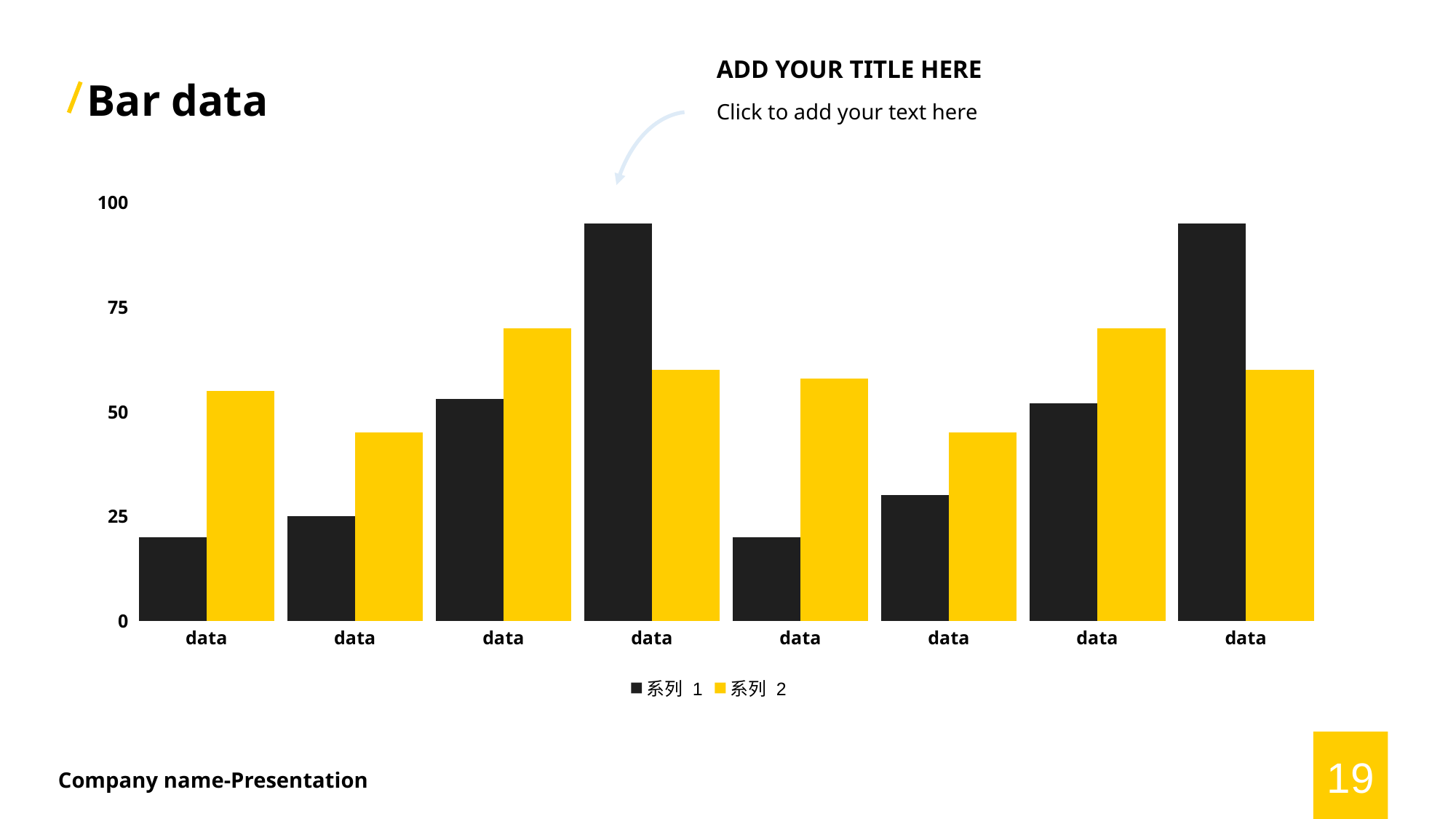
How many categories are plotted along the x axis? 8 Which series contains the tallest bar in the chart? 系列 1 Is the 系列 1 value for the first category (leftmost) greater or less than 25? less In the fourth category from the left, which series has the larger value, 系列 1 or 系列 2? 系列 1 How many series does the chart legend list? 2 What colour are the bars for 系列 2? yellow What are the two entries in the chart legend? 系列 1 and 系列 2 What kind of chart is shown on the slide? bar chart Is the 系列 1 value for the fourth category from the left greater or less than 75? greater In the first category (leftmost), which series has the larger value, 系列 1 or 系列 2? 系列 2 Is the 系列 2 value for the fifth category from the left greater or less than 50? greater